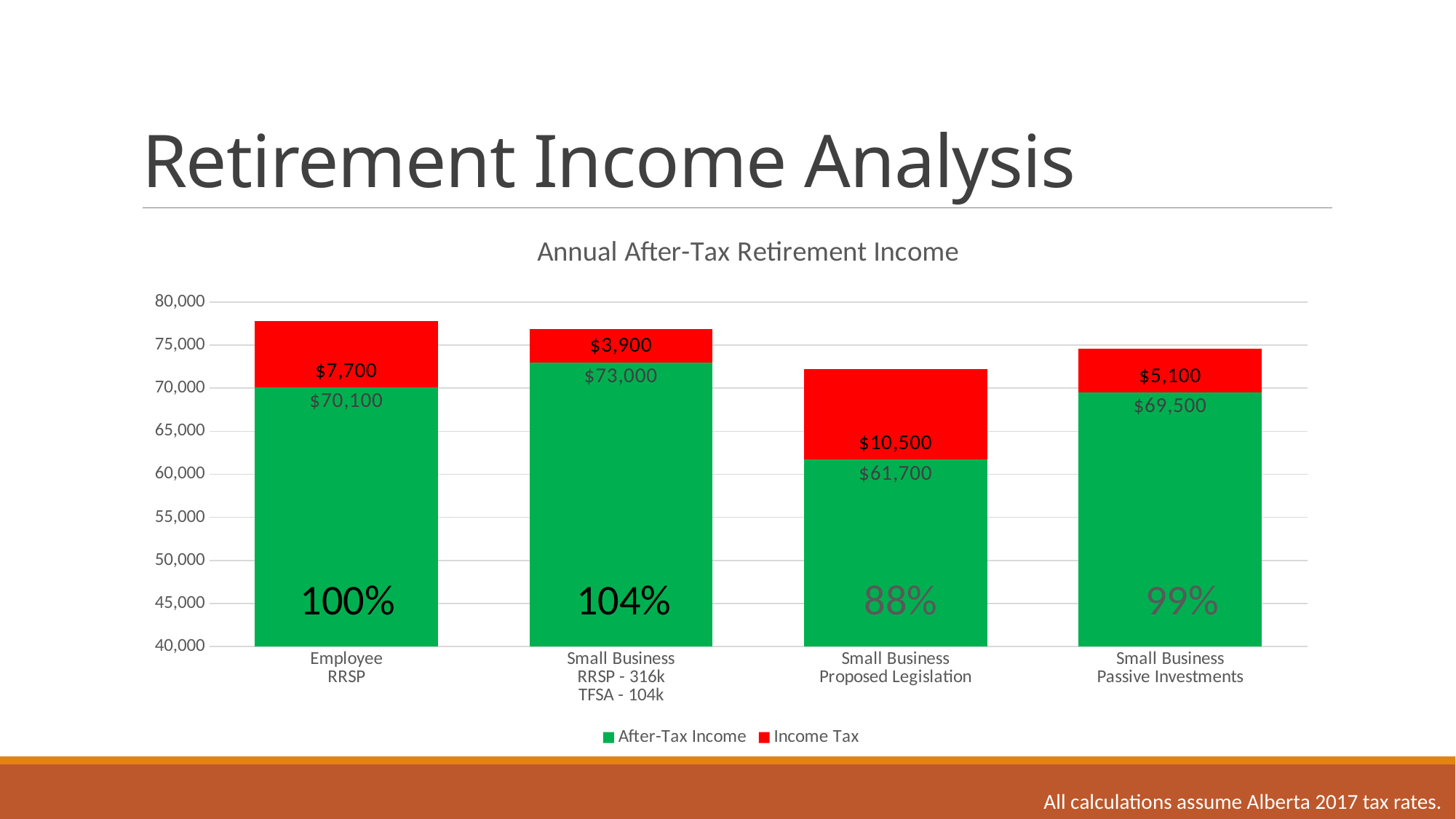
What is the After-Tax Income value for Employee RRSP? $70,100 What kind of chart is shown on the slide? Stacked bar chart What is the difference in Income Tax between Small Business Proposed Legislation and Employee RRSP? $2,800 Which is larger, the After-Tax Income for Employee RRSP or for Small Business Passive Investments? Employee RRSP Which category has the lowest Income Tax? Small Business RRSP - 316k TFSA - 104k What percentage label is shown on the Small Business Proposed Legislation bar? 88% Which category has the highest After-Tax Income? Small Business RRSP - 316k TFSA - 104k How many series does the legend list? 2 What is the total of the stacked bar for Small Business Proposed Legislation? $72,200 What is the After-Tax Income value for Small Business Passive Investments? $69,500 How many categories are shown on the x axis? 4 What is the Income Tax value for Small Business Proposed Legislation? $10,500